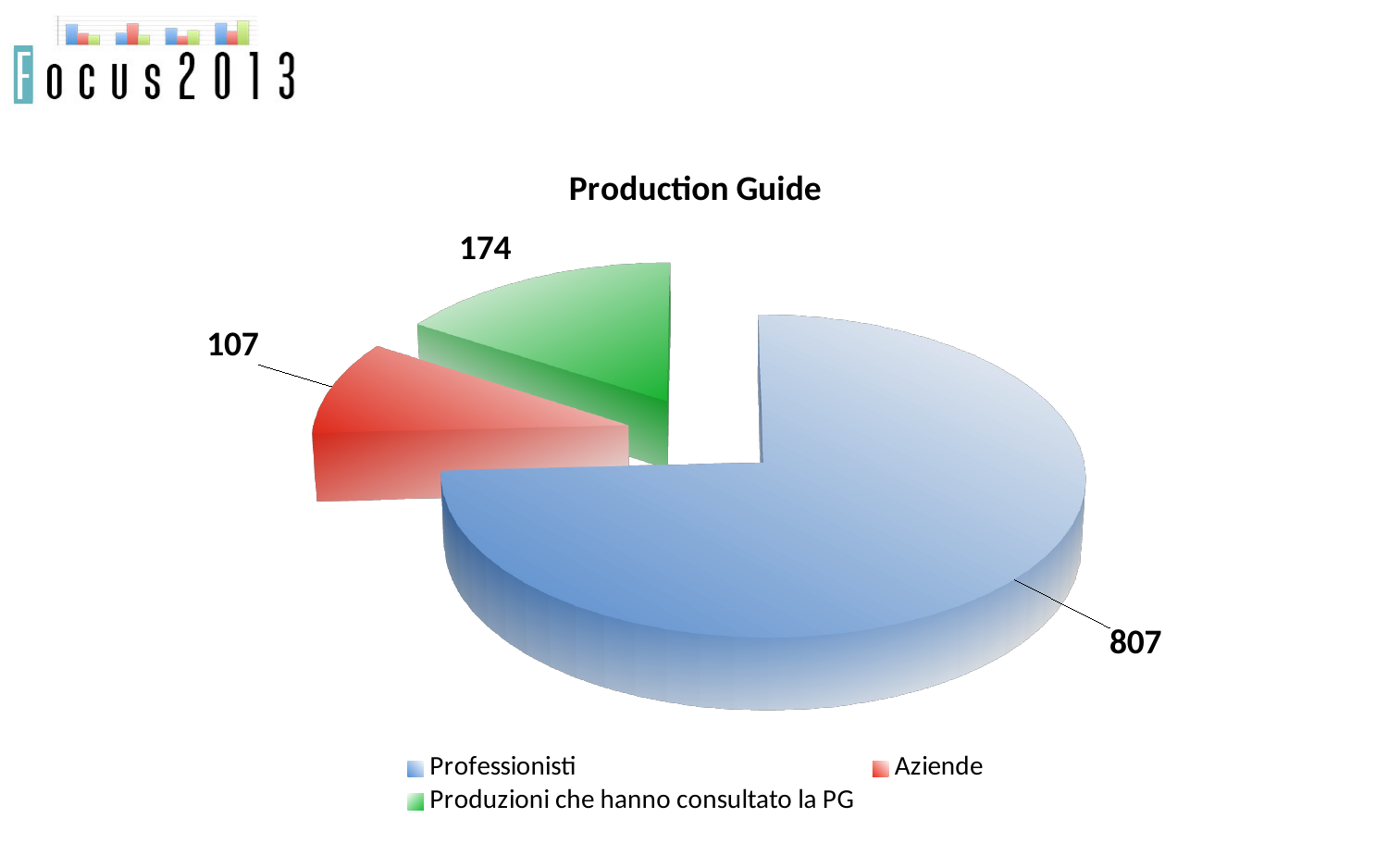
What is the difference between the values for Professionisti and Aziende in the Production Guide chart? 700 What colour is the Aziende slice in the Production Guide pie chart? Red What kind of chart is the Production Guide chart? Pie chart What is the value for Produzioni che hanno consultato la PG in the Production Guide pie chart? 174 What is the difference between the values for Produzioni che hanno consultato la PG and Aziende in the Production Guide chart? 67 What is the value for Aziende in the Production Guide pie chart? 107 How many categories are shown in the Production Guide pie chart? 3 Which is larger in the Production Guide chart, Aziende or Produzioni che hanno consultato la PG? Produzioni che hanno consultato la PG What is the value for Professionisti in the Production Guide pie chart? 807 Which category has the smallest slice in the Production Guide pie chart? Aziende Which category has the largest slice in the Production Guide pie chart? Professionisti What is the total of all slices in the Production Guide pie chart? 1088